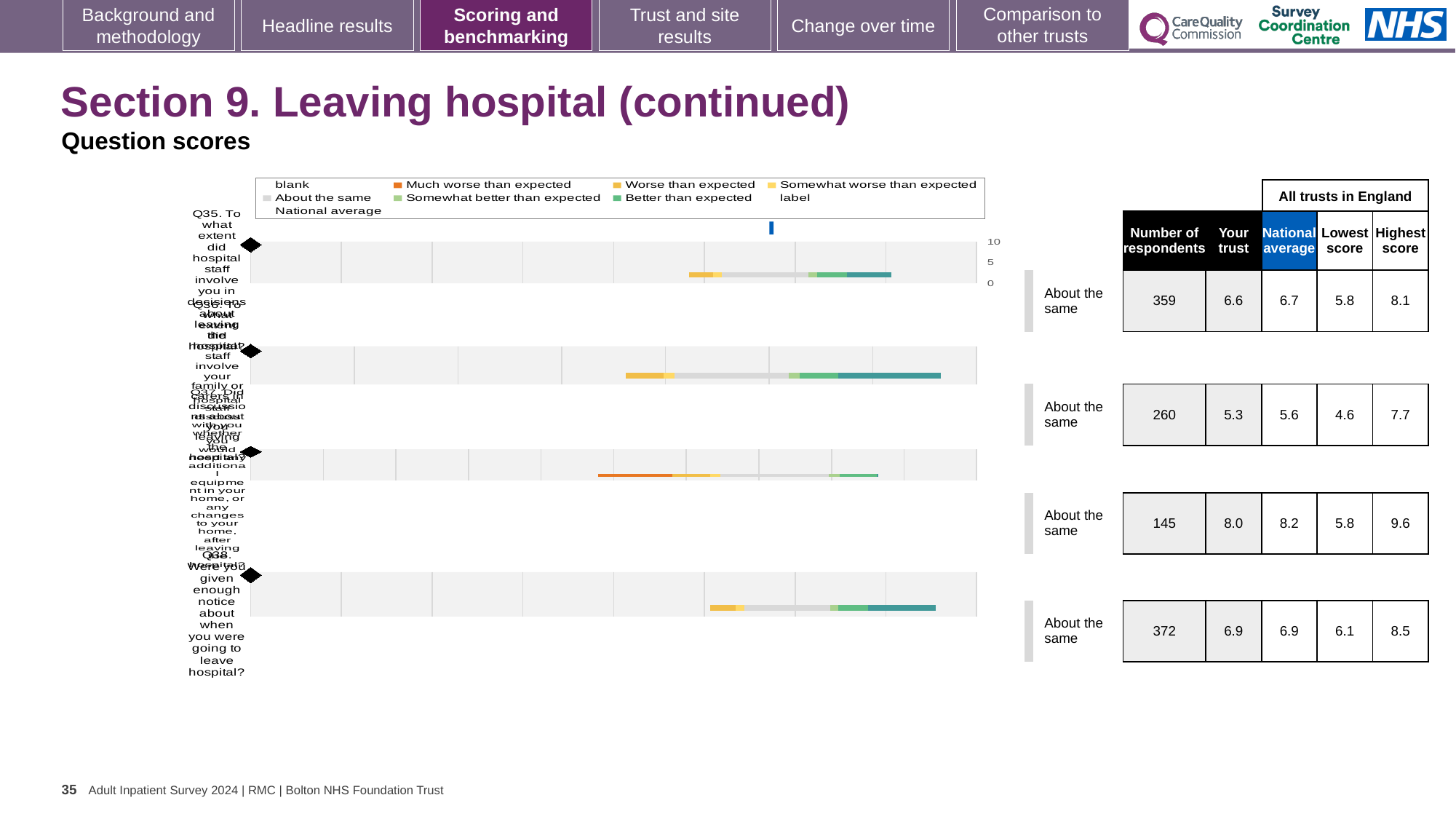
What is the lowest score among all trusts in England for Q36? 4.6 What benchmark category is shown for all four questions in the chart? About the same What is the highest score among all trusts in England for Q38? 8.5 For Q36, which is larger: the 'Your trust' score or the national average? National average What kind of chart is shown on the slide? bar chart Which question has the highest 'Your trust' score? Q37 What is the 'Your trust' score for Q36? 5.3 What is the difference between the highest score and the lowest score for Q35? 2.3 How many questions (rows) are plotted in the chart? 4 What is the national average score for Q37? 8.2 What is the number of respondents for Q35? 359 Which question has the lowest number of respondents? Q37